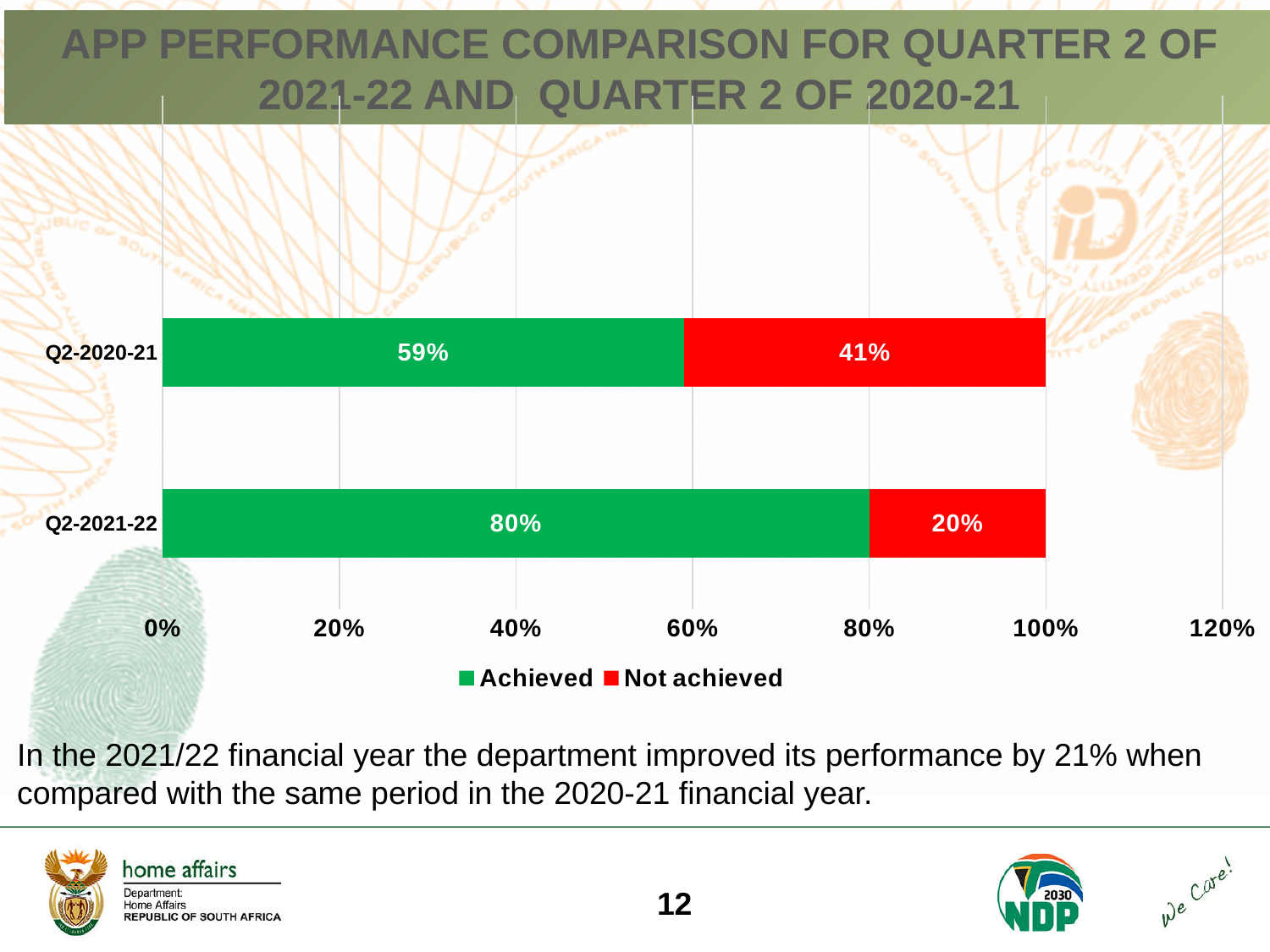
How many quarters are shown on the chart? 2 Which quarter has the lower Not achieved percentage? Q2-2021-22 What percentage was Achieved in Q2-2021-22? 80% What is the total of the stacked bar for Q2-2020-21? 100% How many series does the legend list? 2 Which quarter has the higher Achieved percentage? Q2-2021-22 What percentage was Not achieved in Q2-2020-21? 41% What is the difference between the Achieved percentages for Q2-2021-22 and Q2-2020-21? 21% What kind of chart is shown on the slide? Stacked bar chart What percentage was Achieved in Q2-2020-21? 59% What percentage was Not achieved in Q2-2021-22? 20% Is the Not achieved value for Q2-2020-21 larger or smaller than the Not achieved value for Q2-2021-22? larger